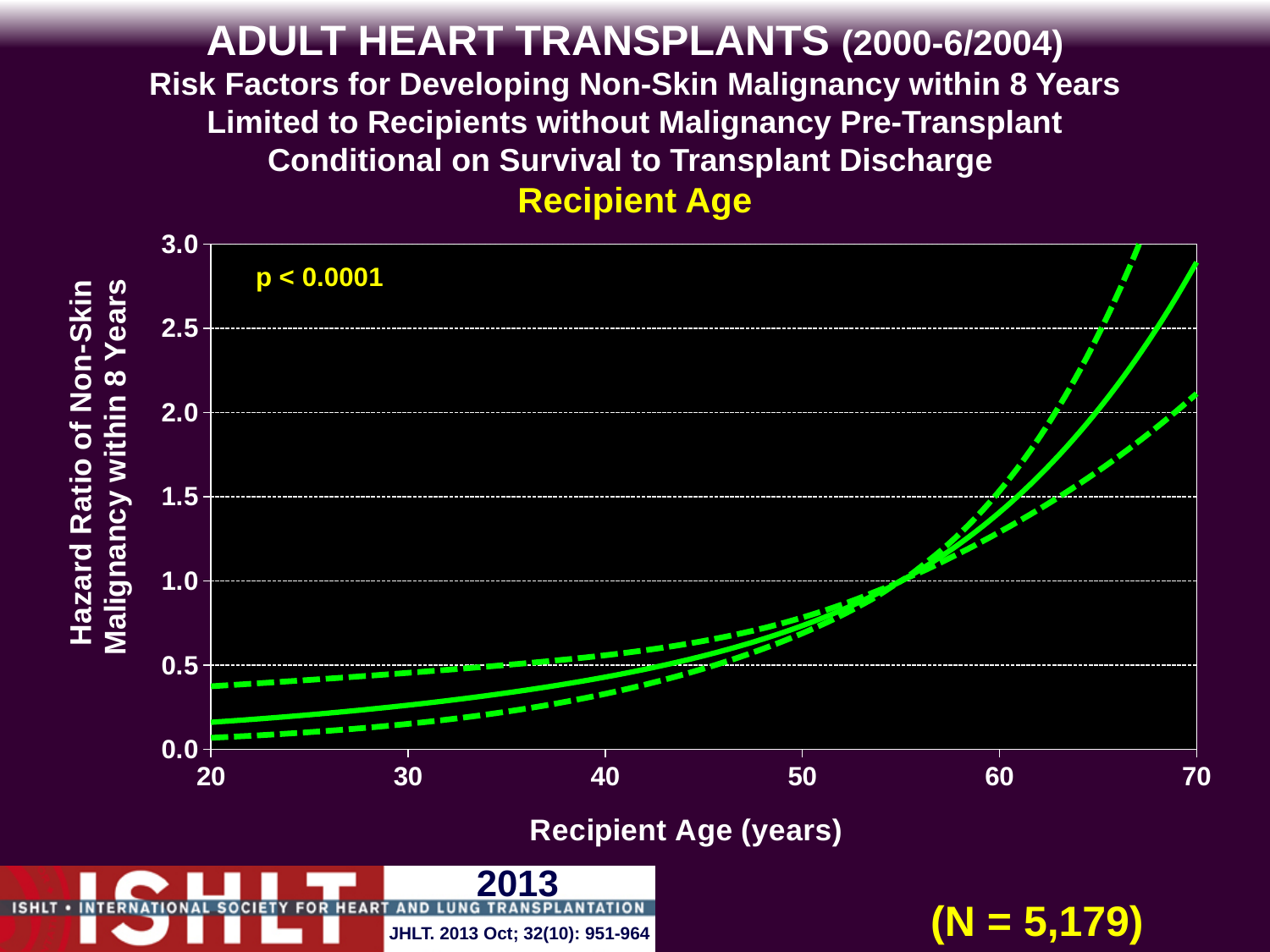
Is the hazard ratio on the solid line at recipient age 20 greater or less than 0.5? less Is the hazard ratio on the solid line at recipient age 60 greater or less than 1.0? greater What kind of chart is shown on the slide? line chart Is the hazard ratio on the solid line at recipient age 70 greater or less than 2.5? greater What p-value is printed on the chart? p < 0.0001 Which recipient age has the higher hazard ratio on the solid line, 30 or 60? 60 How many lines are plotted on the chart? 3 What sample size (N) is shown on the slide? N = 5,179 Does the hazard ratio rise or fall as recipient age increases from 20 to 70 years? rises